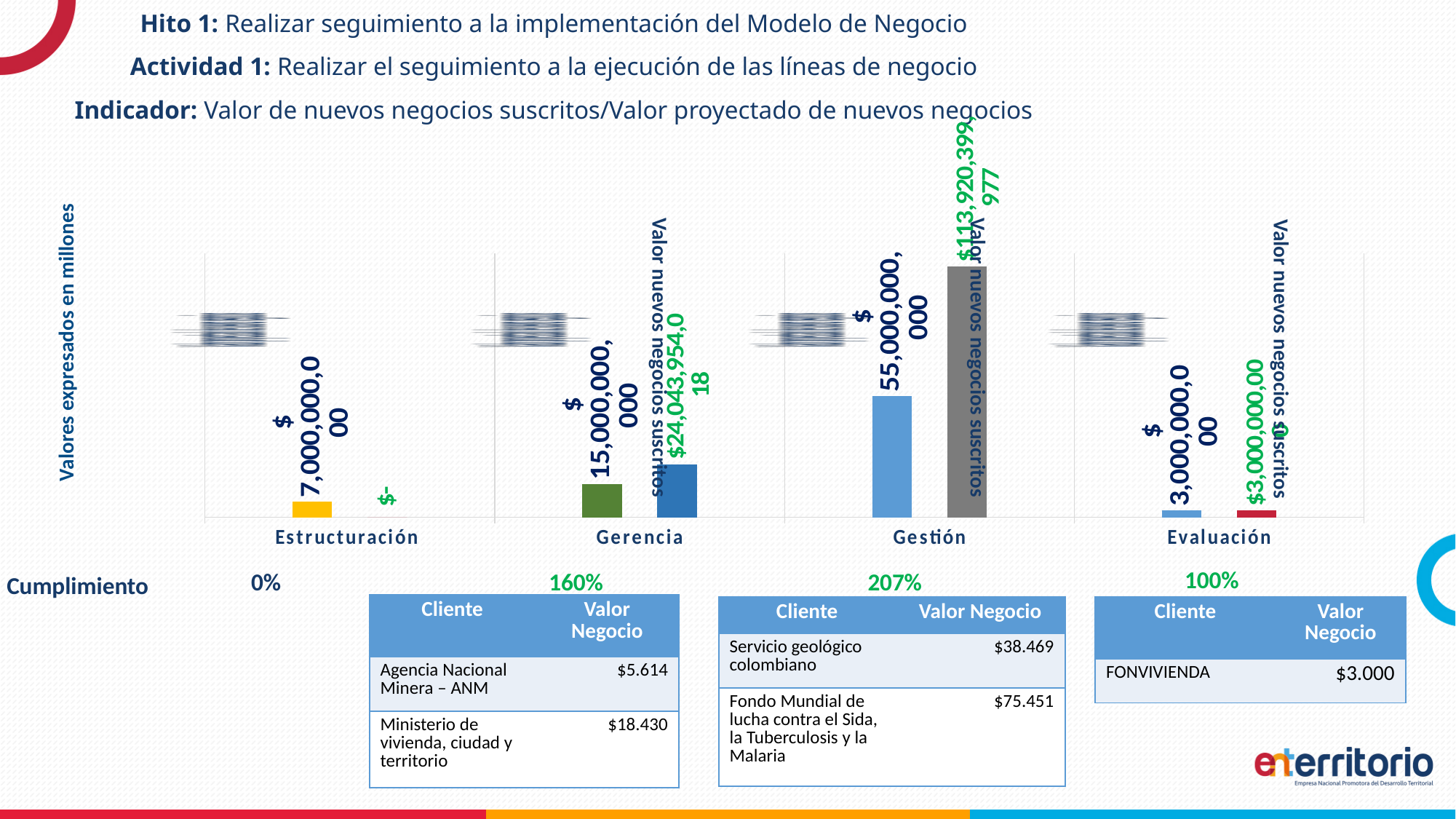
What is the value of 'Valor nuevos negocios suscritos' for Gerencia? $24,043,954,018 What is the projected value (blue label) for Estructuración? $7,000,000,000 For Gerencia, which is larger: the projected value or the 'Valor nuevos negocios suscritos'? Valor nuevos negocios suscritos What is the value of 'Valor nuevos negocios suscritos' for Gestión? $113,920,399,977 Which category has the tallest bar in the chart? Gestión Which category has the lowest projected value (blue label)? Evaluación What is the projected value (blue label) for Gerencia? $15,000,000,000 What is the difference between the 'Valor nuevos negocios suscritos' and the projected value for Gestión? $58,920,399,977 What is the value of 'Valor nuevos negocios suscritos' for Estructuración? $- What is the projected value (blue label) for Gestión? $55,000,000,000 What kind of chart is shown on the slide? bar chart How many categories are shown along the x axis of the chart? 4